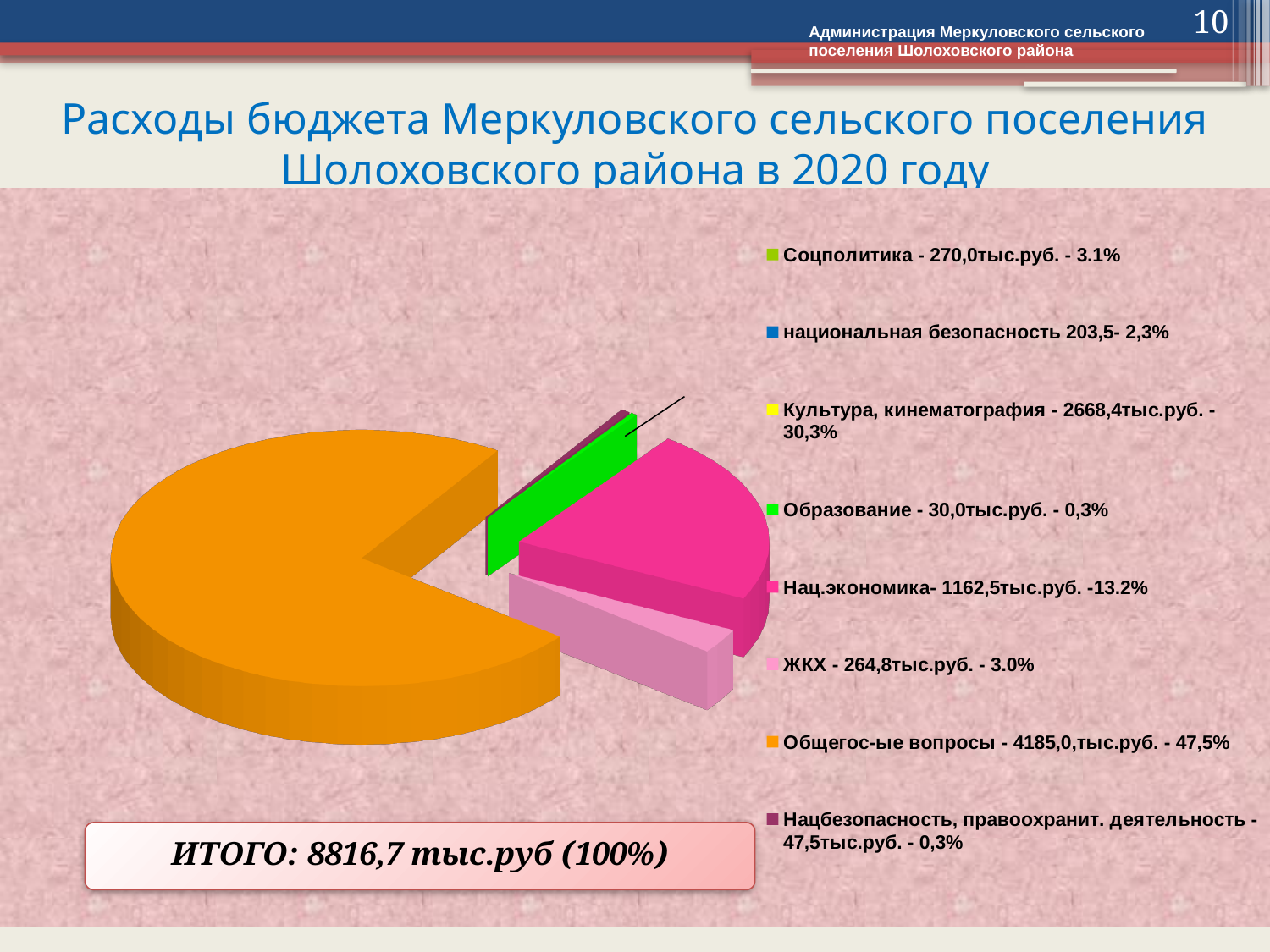
What is the value for ЖКХ? 264,8тыс.руб. How many categories does the legend of the pie chart list? 8 Which is larger: Соцполитика or национальная безопасность? Соцполитика What is the value for Культура, кинематография? 2668,4тыс.руб. What percentage share does Нац.экономика have? 13.2% What colour is the slice for Общегос-ые вопросы? Orange What is the total of all budget expenditures shown (ИТОГО)? 8816,7 тыс.руб Which category has the largest share of the pie? Общегос-ые вопросы What is the difference in value between Общегос-ые вопросы and Культура, кинематография? 1516,6 тыс.руб. Which category has the smallest value in thousand rubles? Образование What type of chart is shown on the slide? Pie chart What share of the pie does Общегос-ые вопросы represent? 47,5%